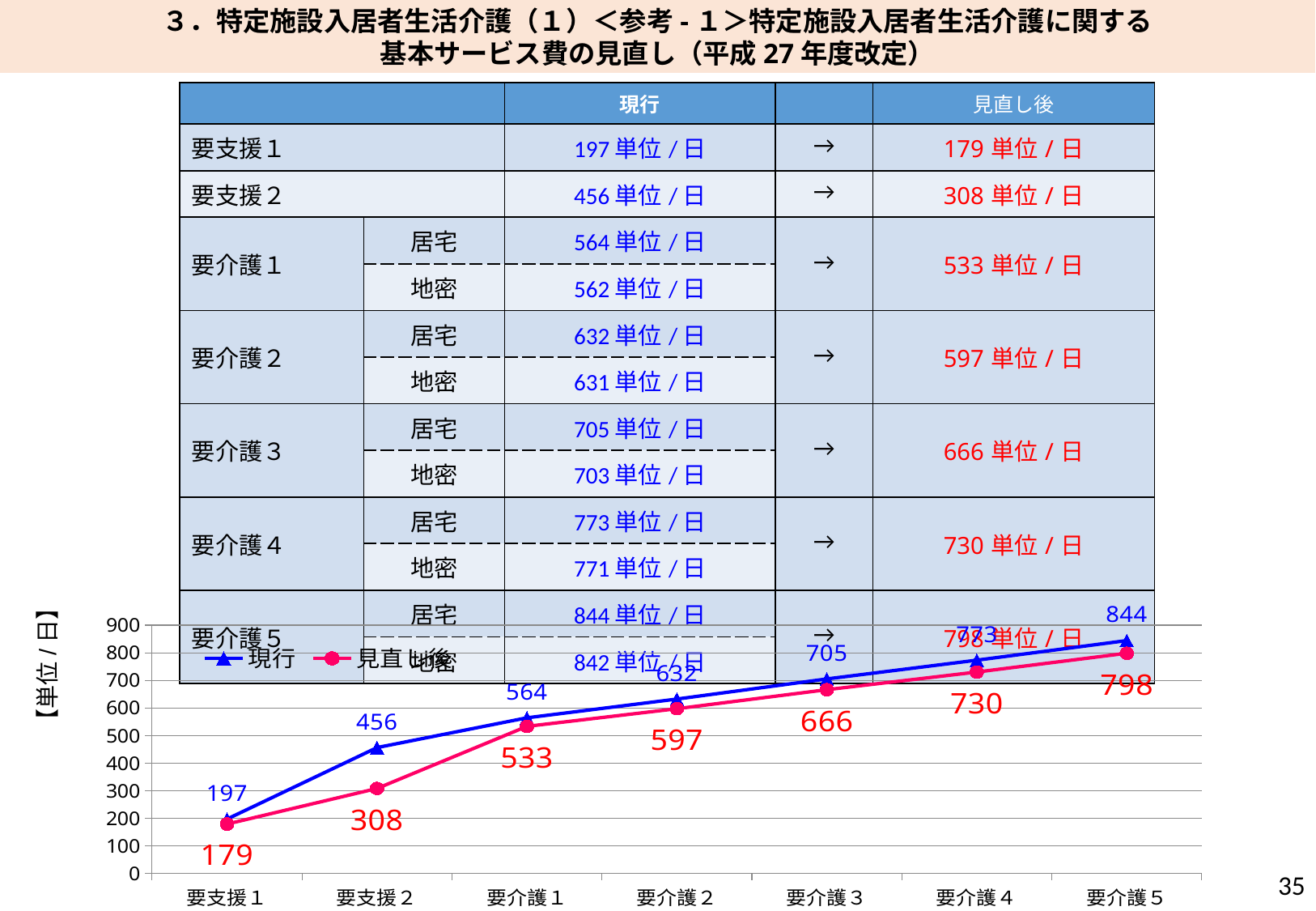
Do the 見直し後 values rise or fall from 要支援1 to 要介護5 in the chart? rise What is the 現行 value for 要支援2 in the chart? 456 What is the difference between the 現行 and 見直し後 values for 要支援2 in the chart? 148 How many series does the chart legend list? 2 What is the 現行 value for 要介護5 in the chart? 844 Which category has the highest 現行 value in the chart? 要介護5 What is the 見直し後 value for 要介護3 in the chart? 666 What kind of chart is shown at the bottom of the slide? line chart How many categories are shown on the x axis of the chart? 7 What is the 見直し後 value for 要支援1 in the chart? 179 For 要介護1, which is larger in the chart: the 現行 value or the 見直し後 value? 現行 Which category has the lowest 見直し後 value in the chart? 要支援1